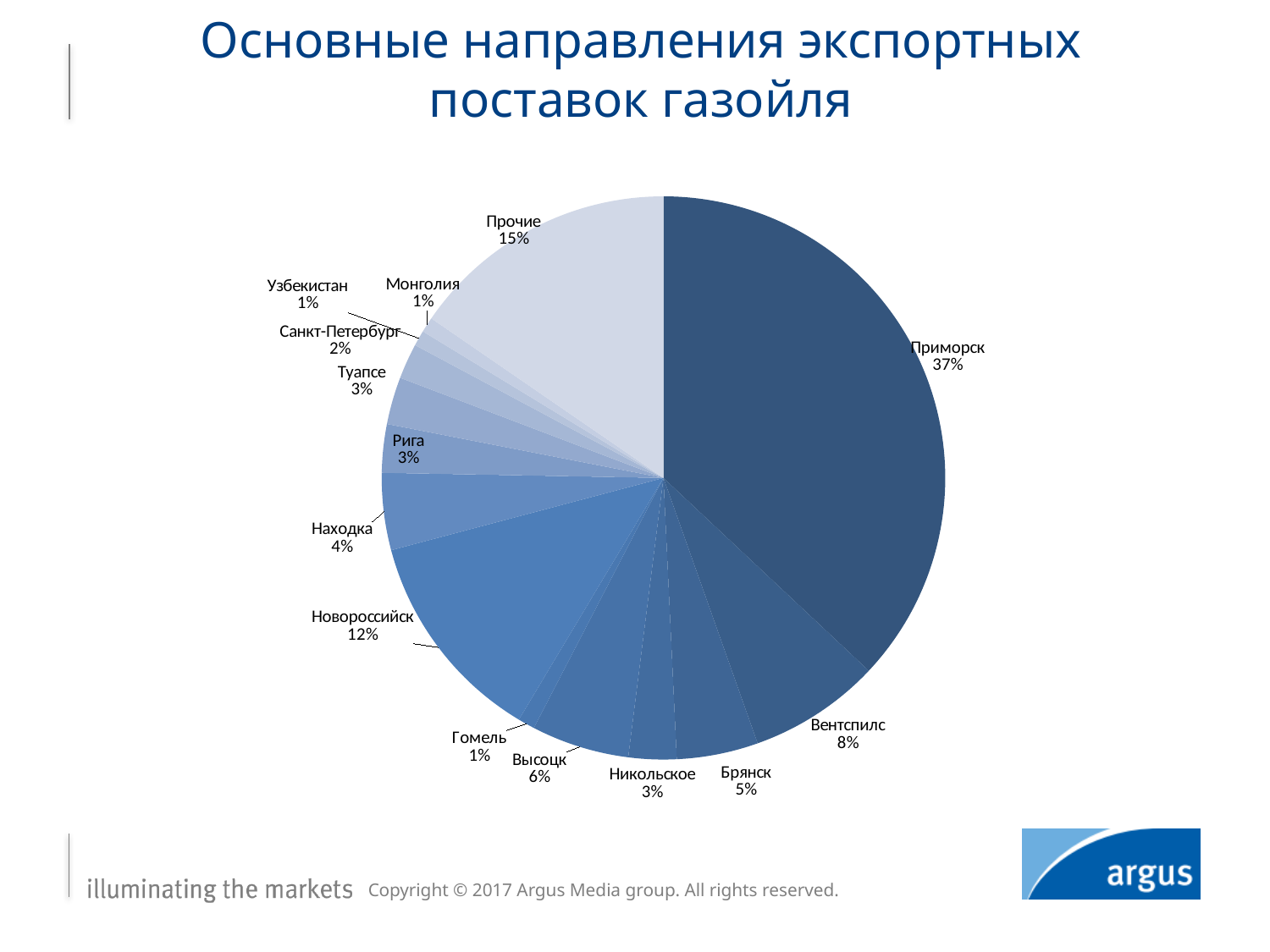
Which slice of the pie is the largest? Приморск What share is shown for Новороссийск? 12% What share is shown for Прочие? 15% What is the difference in percentage points between Приморск and Новороссийск? 25 What kind of chart is shown on the slide? pie chart Which is larger, the share for Новороссийск or the share for Вентспилс? Новороссийск What share of gasoil export supplies goes through Приморск? 37% What share is shown for Высоцк? 6% How many slices does the pie chart have? 14 What is the difference in percentage points between Вентспилс and Брянск? 3 What share is shown for Вентспилс? 8% What is the title of the slide? Основные направления экспортных поставок газойля